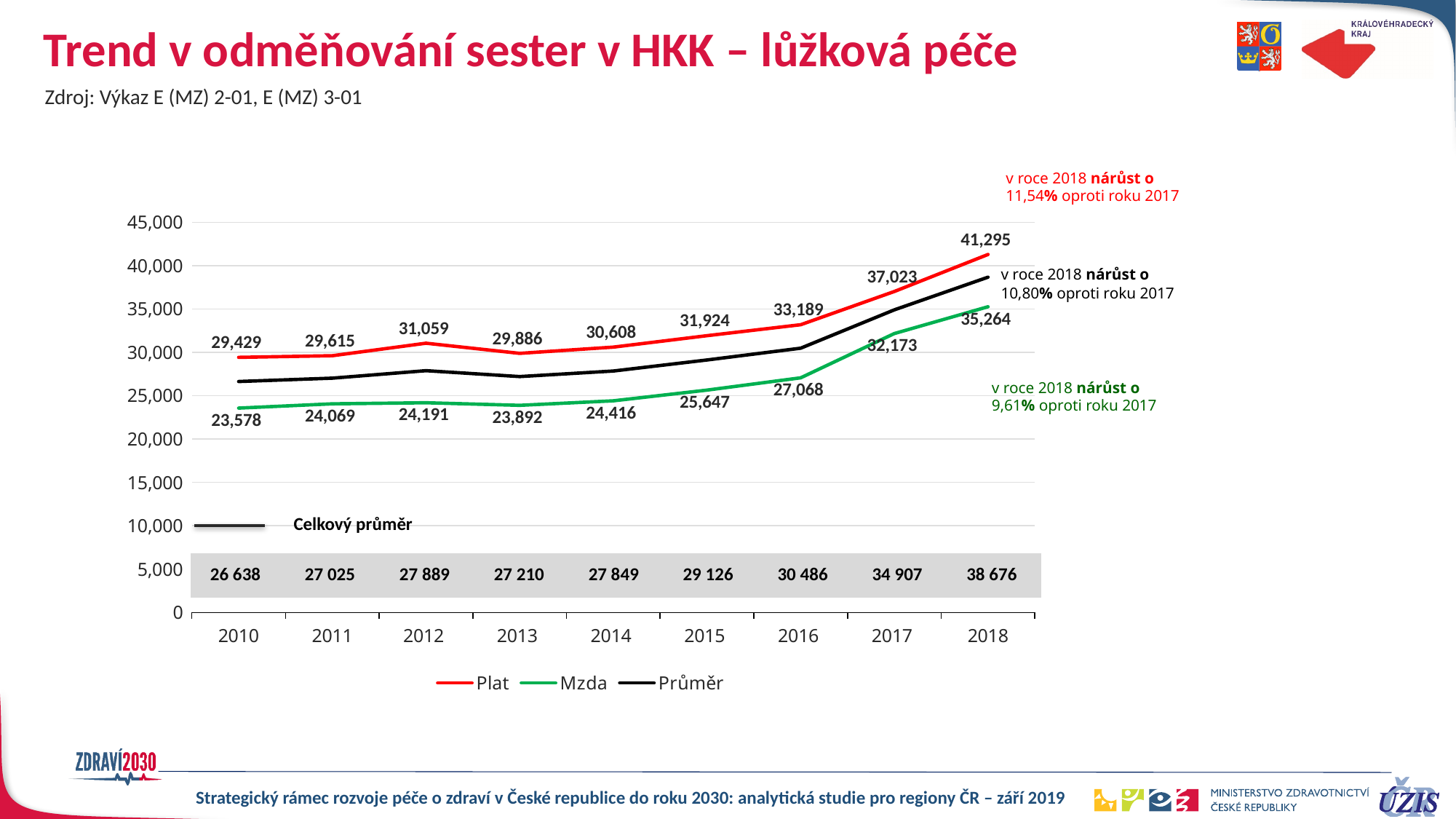
In which year is the Mzda series lowest? 2010 How many years are shown on the x axis? 9 What is the Celkový průměr value shown for 2016? 30 486 What is the difference between Plat and Mzda in 2010? 5,851 How many series does the legend list? 3 Does the Mzda series rise or fall from 2015 to 2018? rise What is the value of Plat in 2018? 41,295 Which year has the larger Plat value, 2012 or 2013? 2012 What is the difference between the Plat value in 2018 and in 2017? 4,272 What is the value of Mzda in 2013? 23,892 What kind of chart is shown on the slide? line chart In which year is the Plat series highest? 2018